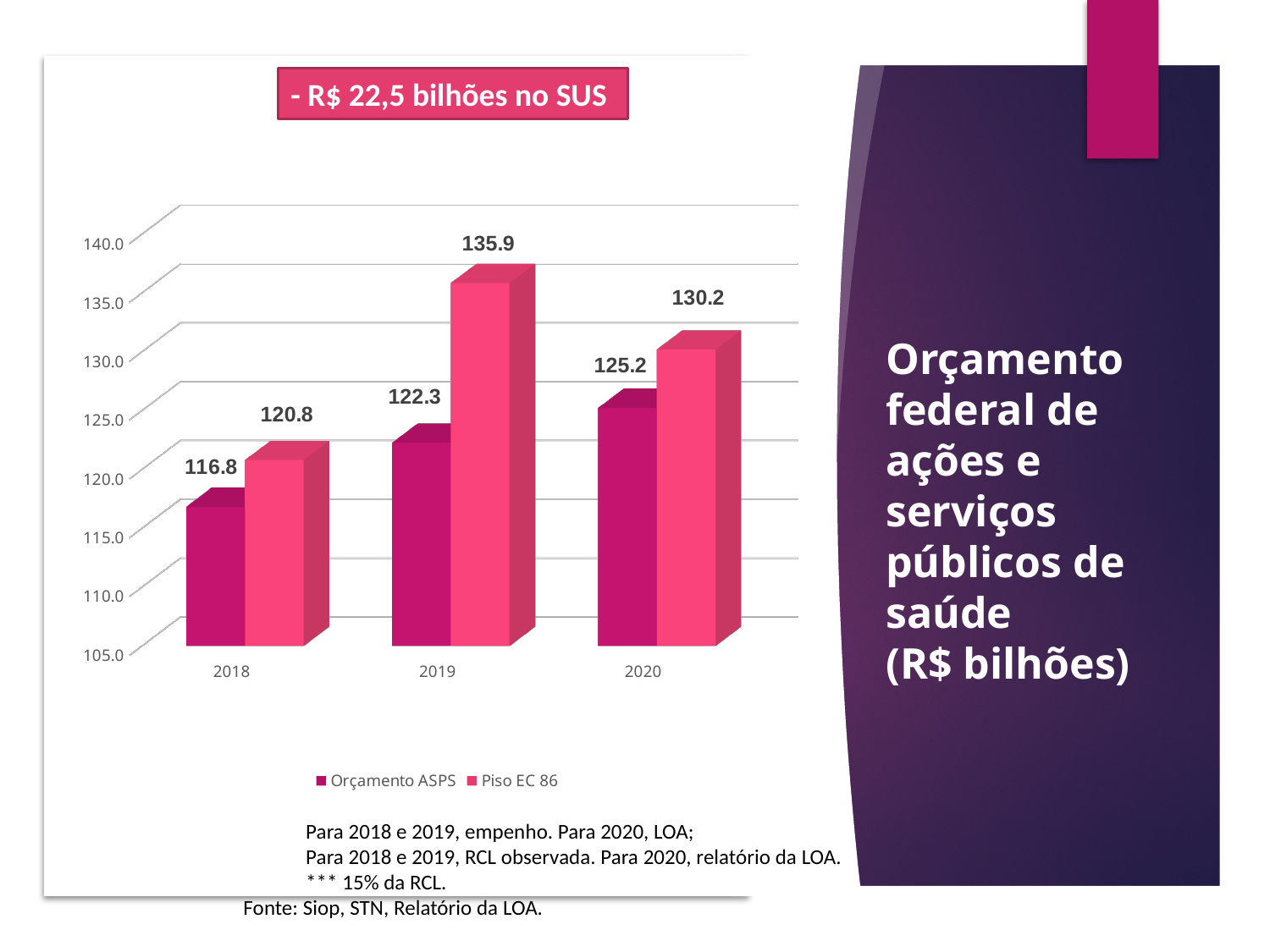
Does the Orçamento ASPS value rise or fall from 2018 to 2020? Rise What kind of chart is shown on the slide? Bar chart In which year is the Piso EC 86 value highest? 2019 Which is larger in 2020, Orçamento ASPS or Piso EC 86? Piso EC 86 In which year is the Orçamento ASPS value lowest? 2018 What is the value of Piso EC 86 for 2020? 130.2 What is the value of Orçamento ASPS for 2020? 125.2 What is the value of Piso EC 86 for 2019? 135.9 What is the value of Orçamento ASPS for 2018? 116.8 How many series does the legend list? 2 What is the difference between Piso EC 86 and Orçamento ASPS in 2019? 13.6 How many years are shown on the x axis? 3